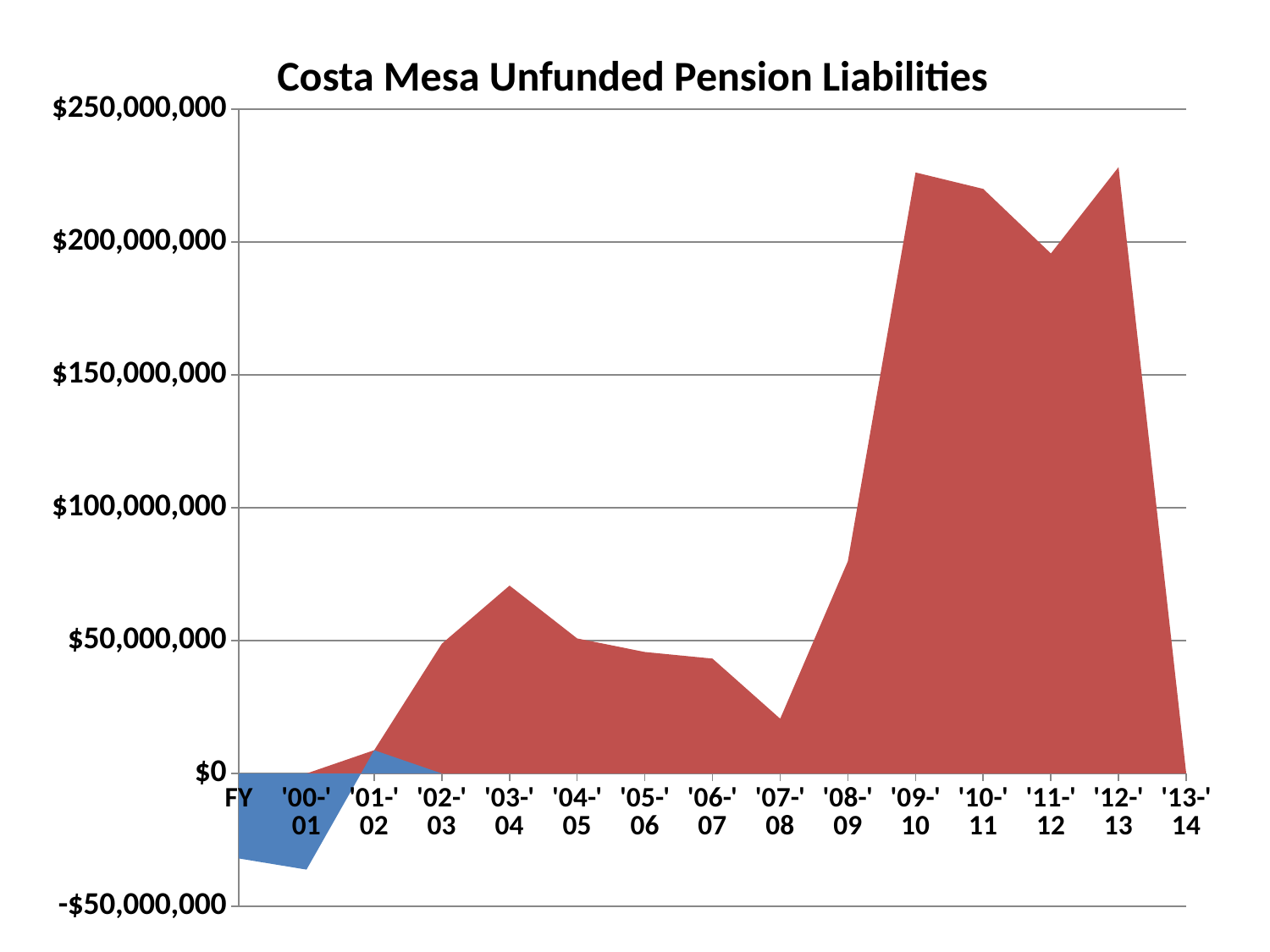
What kind of chart is shown on the slide? Area chart How many fiscal-year categories are labelled on the x axis? 15 Is the value for '00-'01 greater or less than $0? less Which is larger, the value for '03-'04 or the value for '04-'05? '03-'04 What is the title of the chart? Costa Mesa Unfunded Pension Liabilities Is the value for '03-'04 greater or less than $50,000,000? greater Which is larger, the value for '10-'11 or the value for '11-'12? '10-'11 Is the value for '09-'10 greater or less than $200,000,000? greater Do the values rise or fall from '03-'04 to '07-'08? fall